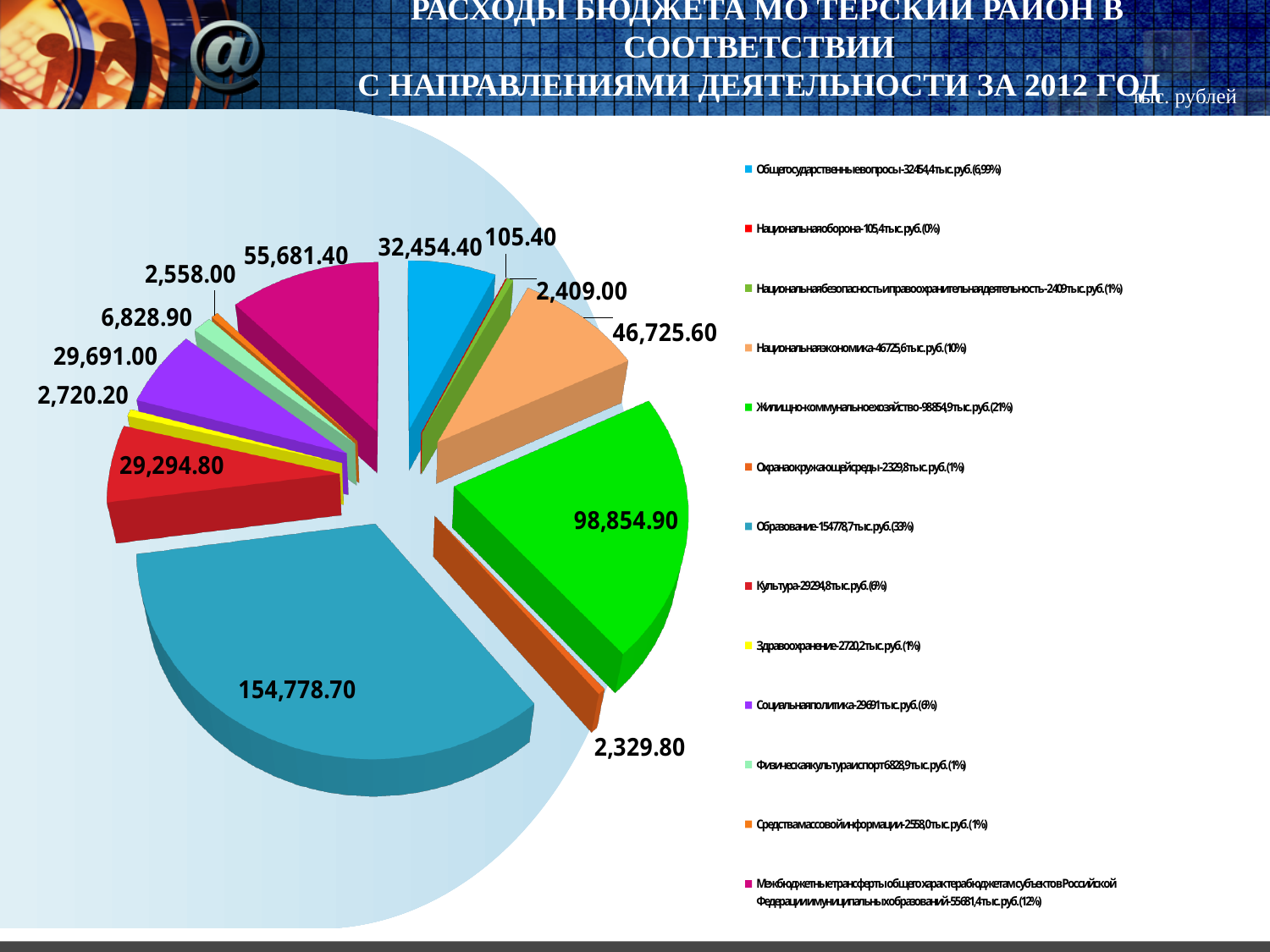
Which category has the smallest slice of the pie? Национальная оборона Which category has the largest slice of the pie? Образование According to the legend, what share of the pie does Образование represent? 33% What is the value shown for Жилищно-коммунальное хозяйство? 98,854.90 Which is larger, the value for Культура or the value for Социальная политика? Социальная политика In what units are the values on the chart expressed, according to the slide? тыс. рублей How many entries does the legend list? 13 What is the difference between the values for Образование and Жилищно-коммунальное хозяйство? 55,923.80 How many slices does the pie chart have? 13 What kind of chart is shown on the slide? Pie chart What is the value shown for Образование? 154,778.70 What is the value shown for Национальная экономика? 46,725.60